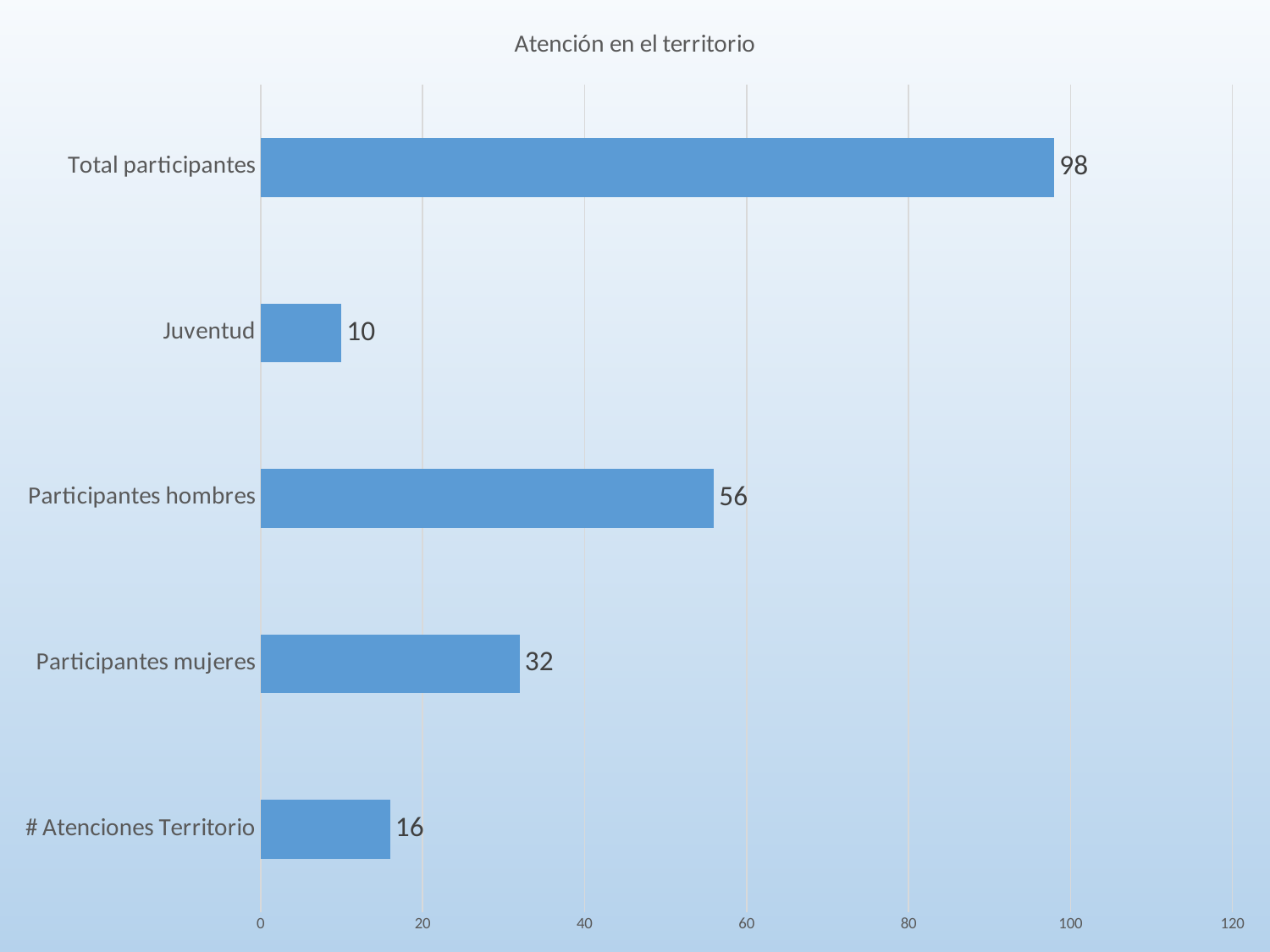
Is the value for Participantes hombres greater or less than 60? less Which is larger, Participantes mujeres or # Atenciones Territorio? Participantes mujeres What is the value for # Atenciones Territorio? 16 What is the value for Total participantes? 98 What kind of chart is this? bar chart Which category has the highest value? Total participantes What is the value for Juventud? 10 What is the difference between Participantes hombres and Participantes mujeres? 24 What is the title of the chart? Atención en el territorio Which category has the lowest value? Juventud What is the value for Participantes hombres? 56 How many categories are shown in the chart? 5